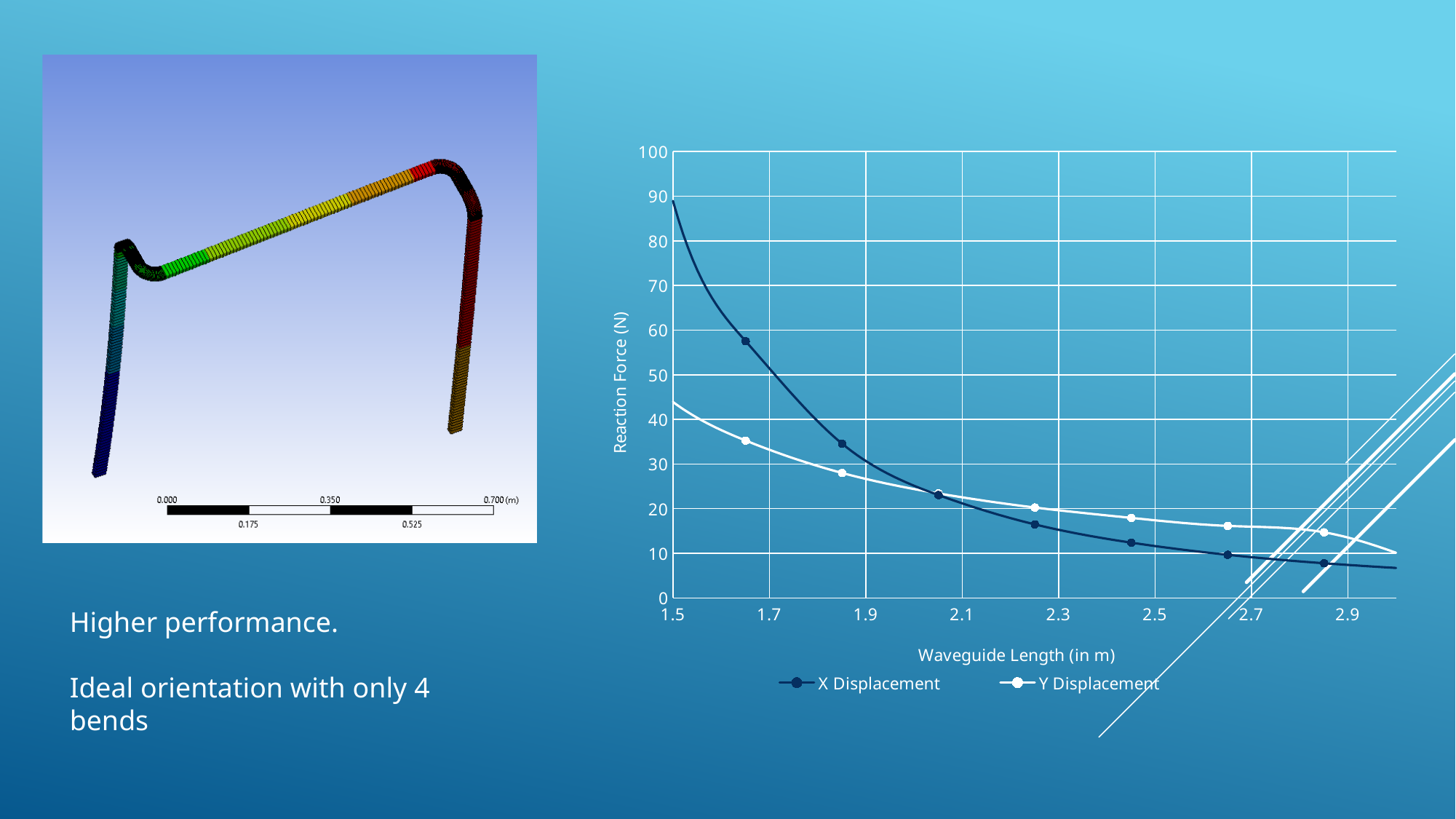
What kind of chart is shown on the slide? line chart How many series does the chart's legend list? 2 Is the Y Displacement reaction force at a waveguide length of about 1.65 m greater or less than 40? less Is the X Displacement reaction force at a waveguide length of about 2.85 m greater or less than 10? less Do the Y Displacement values rise or fall as waveguide length increases? fall What is the label of the chart's vertical axis? Reaction Force (N) What are the two series named in the chart's legend? X Displacement and Y Displacement At a waveguide length of about 2.65 m, which series has the larger reaction force, X Displacement or Y Displacement? Y Displacement At a waveguide length of about 1.65 m, which series has the larger reaction force, X Displacement or Y Displacement? X Displacement Do the X Displacement values rise or fall as waveguide length increases? fall Is the Y Displacement reaction force at a waveguide length of about 2.85 m greater or less than 10? greater